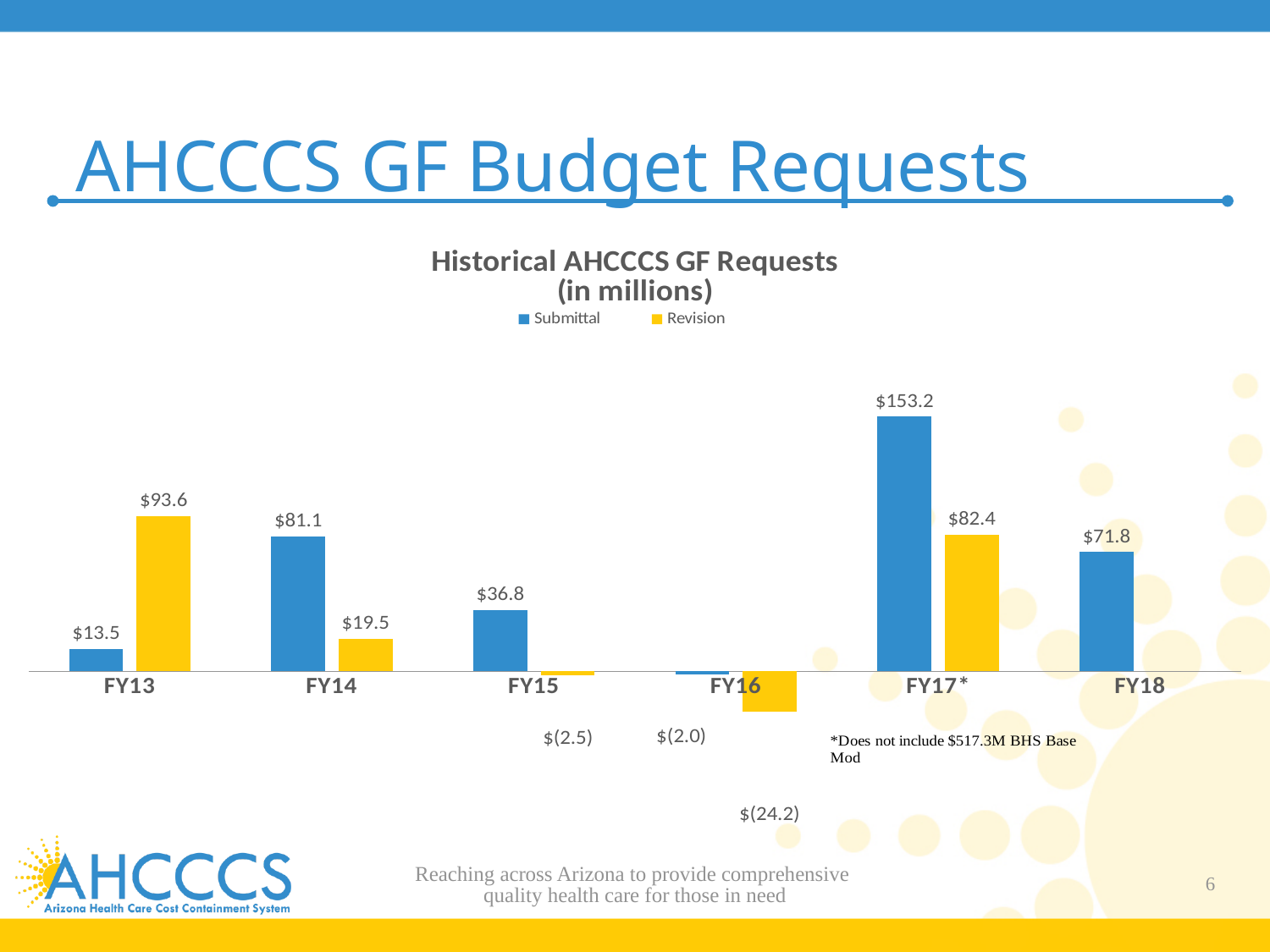
What is the Submittal value for FY17* in the Historical AHCCCS GF Requests chart? $153.2 What is the difference between the Submittal and Revision values for FY17*? $70.8 How many series does the legend list? 2 Which colour represents the Revision series in the chart? Yellow Which is larger for FY14, the Submittal value or the Revision value? Submittal What is the Revision value for FY13? $93.6 What is the Revision value for FY16? $(24.2) How many fiscal years are shown on the x axis? 6 What kind of chart is shown on the slide? Bar chart Which fiscal year has the lowest Revision value? FY16 Which fiscal year has the highest Submittal value? FY17* What is the Submittal value for FY18? $71.8